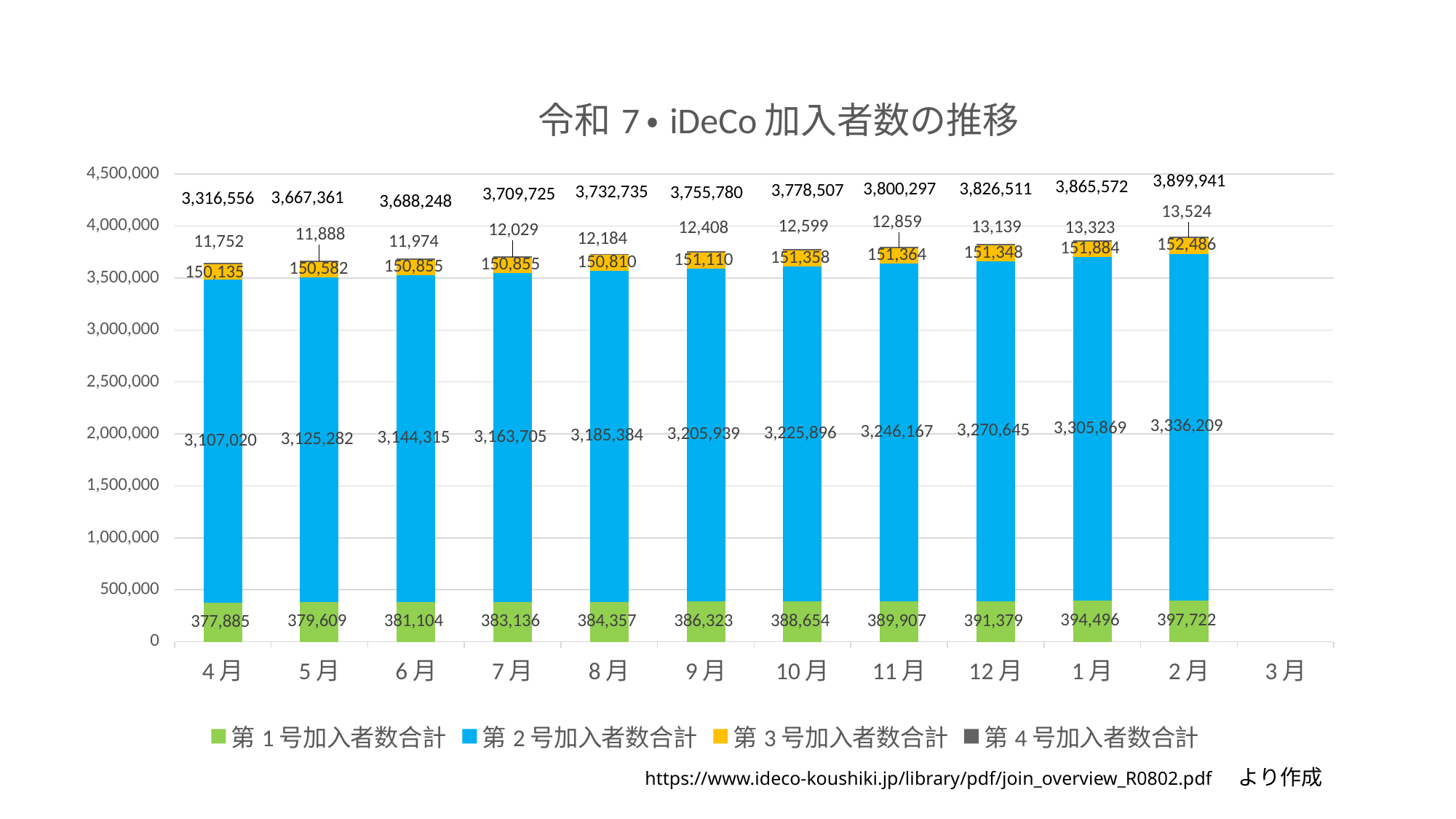
What is the total of the stacked bar for 2月? 3,899,941 What is the value of 第3号加入者数合計 for 1月? 151,884 Does the value of 第2号加入者数合計 rise or fall from 4月 to 2月? Rise What is the difference between the 第1号加入者数合計 values for 2月 and 4月? 19,837 What kind of chart is shown on the slide? Stacked bar chart Which month has the highest value for 第2号加入者数合計? 2月 What is the value of 第1号加入者数合計 for 4月? 377,885 How many series does the legend list? 4 How many month categories are shown on the x axis? 12 Which month has the lowest value for 第1号加入者数合計? 4月 What is the value of 第4号加入者数合計 for 10月? 12,599 What is the value of 第2号加入者数合計 for 2月? 3,336,209